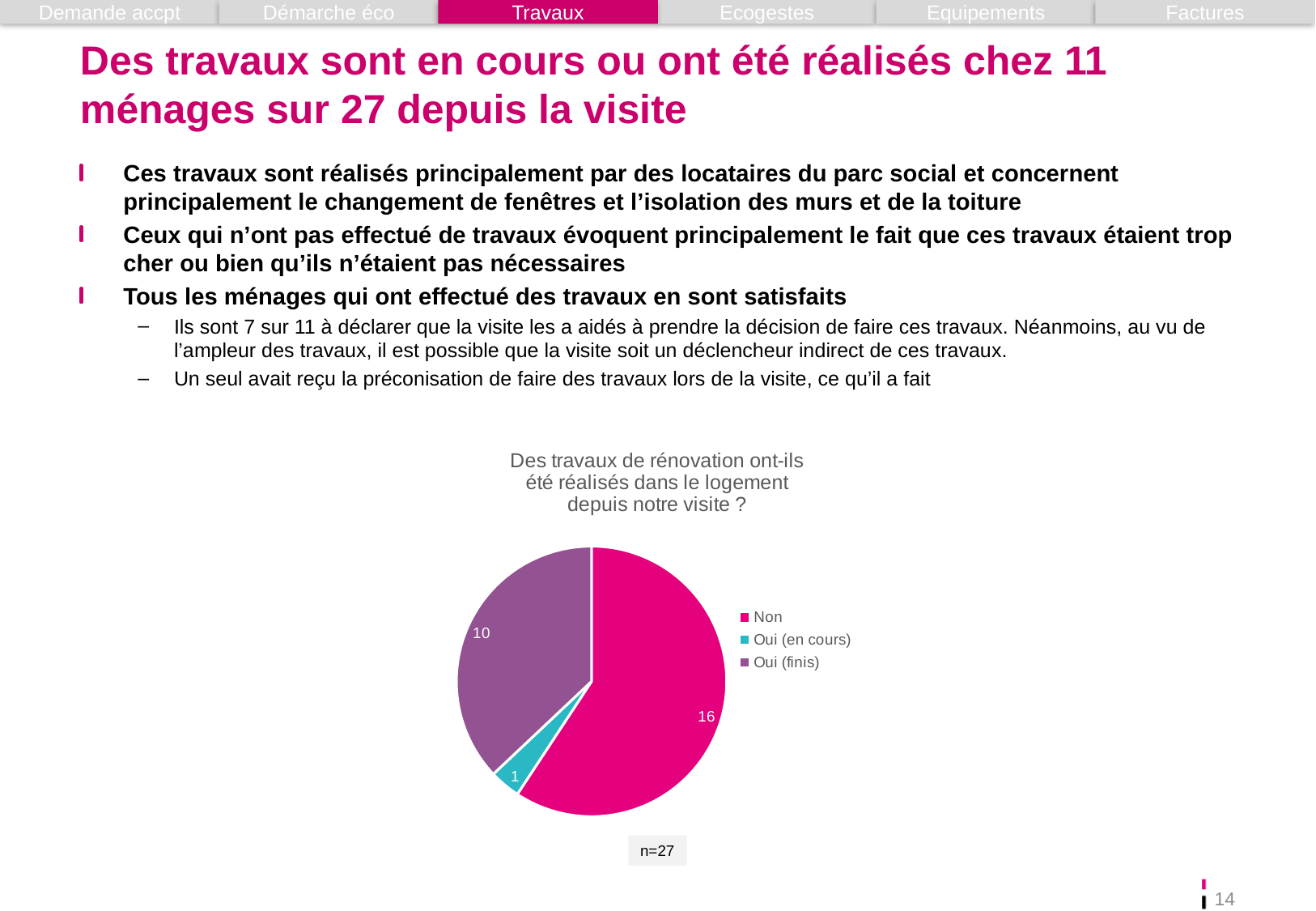
What type of chart is shown on the slide? pie chart What is the value for the "Oui (en cours)" slice of the pie chart? 1 How many slices does the pie chart have? 3 Which category has the smallest slice in the pie chart? Oui (en cours) Which is larger, the "Oui (finis)" slice or the "Oui (en cours)" slice? Oui (finis) What is the difference between the "Non" value and the "Oui (finis)" value? 6 How many entries does the legend of the pie chart list? 3 Which category has the largest slice in the pie chart? Non What sample size is indicated below the pie chart? n=27 What is the total of all slices in the pie chart? 27 What is the value for the "Oui (finis)" slice of the pie chart? 10 What is the value for the "Non" slice of the pie chart? 16